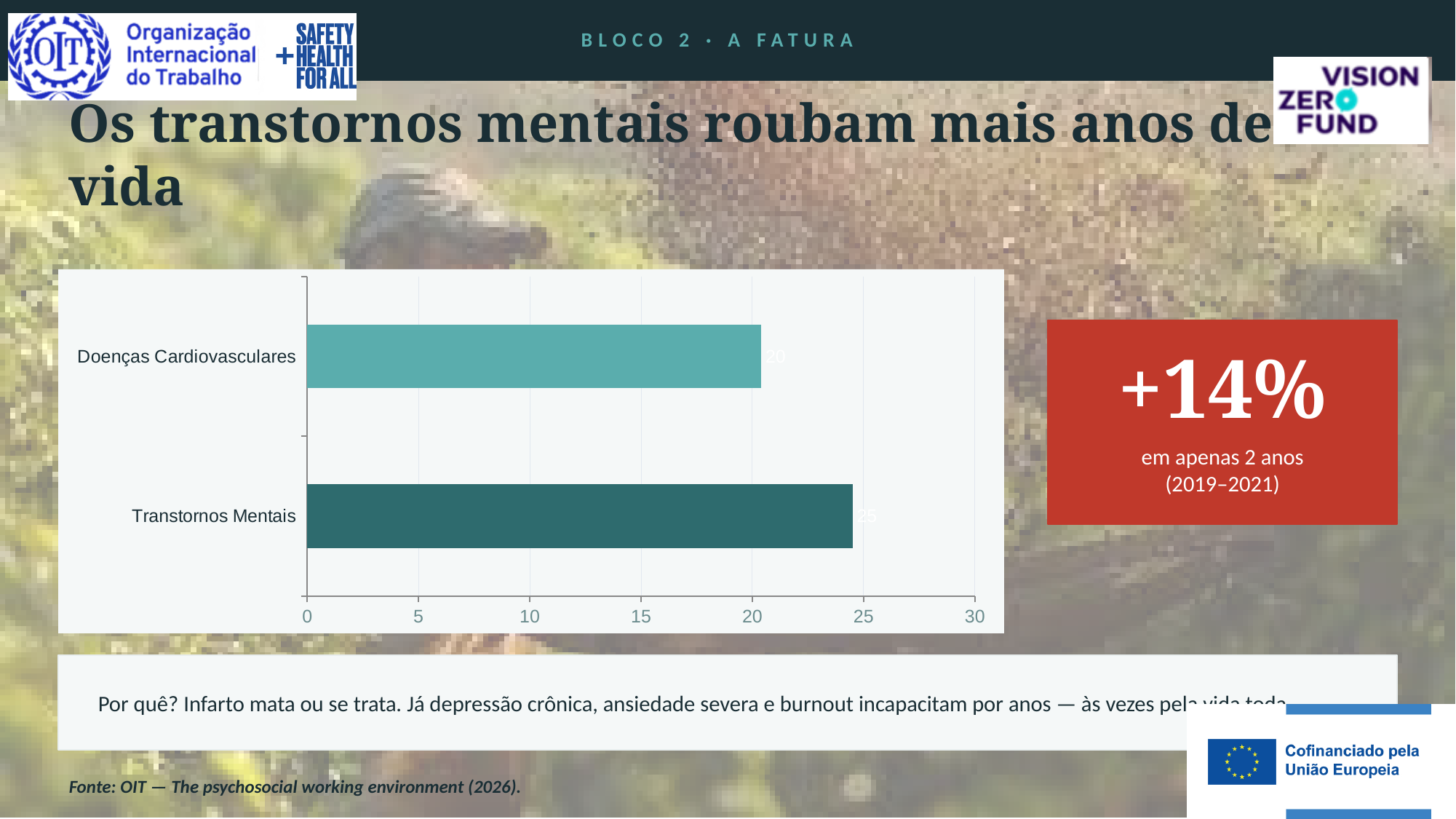
How many categories are shown in the chart? 2 What is the value for Transtornos Mentais? 25 Is the value for Doenças Cardiovasculares greater or less than 15? greater What is the difference between the values for Transtornos Mentais and Doenças Cardiovasculares? 5 Which is larger, the value for Transtornos Mentais or the value for Doenças Cardiovasculares? Transtornos Mentais Which category has the lowest value? Doenças Cardiovasculares What percentage is shown in the red box next to the chart? +14% What is the value for Doenças Cardiovasculares? 20 What kind of chart is shown on the slide? bar chart Is the value for Transtornos Mentais greater or less than 30? less Which category has the highest value? Transtornos Mentais What is the maximum value shown on the chart's horizontal axis? 30